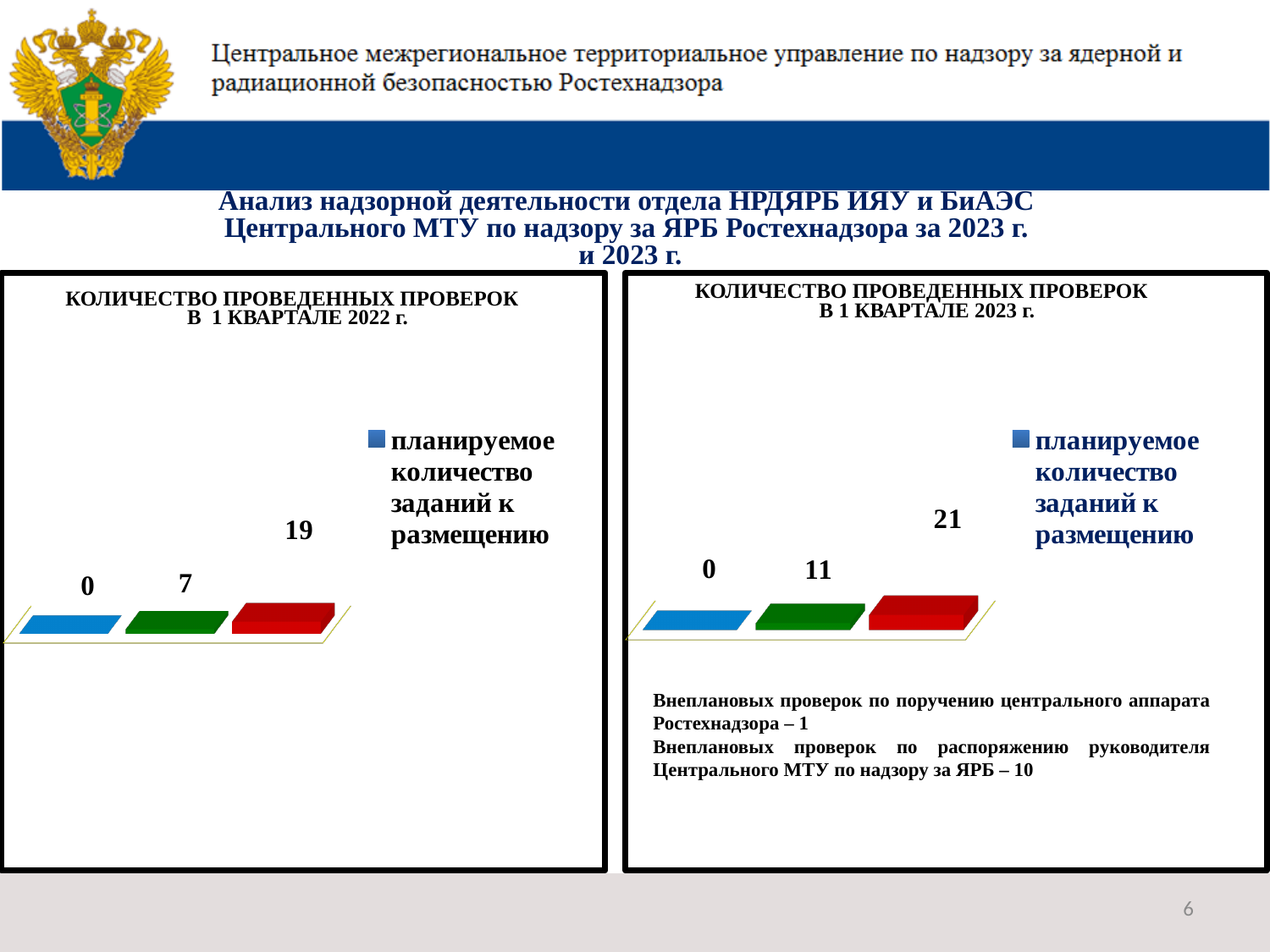
In the right chart (1 квартал 2023 г.), which bar has the highest value? the red bar (21) In the left chart (1 квартал 2022 г.), what value is labelled on the green bar? 7 In the left chart (1 квартал 2022 г.), what value is labelled on the blue bar? 0 What kind of chart is used in the right chart (1 квартал 2023 г.)? bar chart In the left chart (1 квартал 2022 г.), which bar has the lowest value? the blue bar (0) In the chart titled 'КОЛИЧЕСТВО ПРОВЕДЕННЫХ ПРОВЕРОК В 1 КВАРТАЛЕ 2023 г.' (right), what value is labelled on the red bar? 21 In the right chart (1 квартал 2023 г.), what is the difference between the red bar and the green bar? 10 Which chart has the larger value on its red bar, the 2022 chart (left) or the 2023 chart (right)? the 2023 chart (right) In the left chart (1 квартал 2022 г.), what is the difference between the red bar and the green bar? 12 In the right chart (1 квартал 2023 г.), what value is labelled on the green bar? 11 How many bars are plotted in the left chart (1 квартал 2022 г.)? 3 In the chart titled 'КОЛИЧЕСТВО ПРОВЕДЕННЫХ ПРОВЕРОК В 1 КВАРТАЛЕ 2022 г.' (left), what value is labelled on the red bar? 19